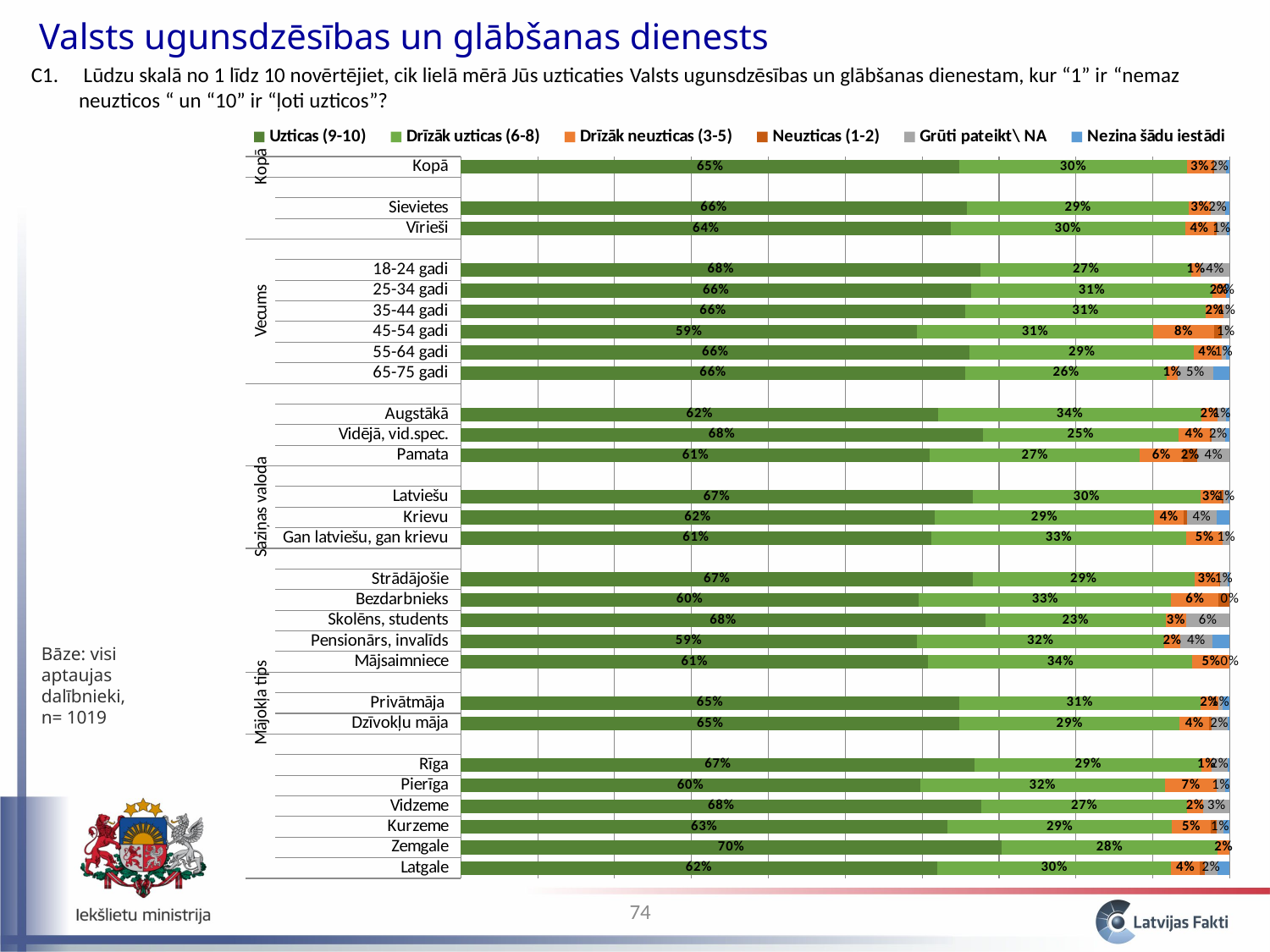
What is the difference between the Uzticas (9-10) values for Sievietes and Vīrieši? 2% Which region has the highest Uzticas (9-10) share among Rīga, Pierīga, Vidzeme, Kurzeme, Zemgale and Latgale? Zemgale How many series does the legend list? 6 What type of chart is shown on the slide? Stacked bar chart Which has a larger Uzticas (9-10) value, Skolēns, students or Bezdarbnieks? Skolēns, students What is the Drīzāk uzticas (6-8) value for Pierīga? 32% What percentage of all respondents (Kopā) answered Uzticas (9-10)? 65% What is the difference between the Drīzāk uzticas (6-8) values for Augstākā and Vidējā, vid.spec.? 9% Which age group has the highest Drīzāk neuzticas (3-5) value? 45-54 gadi What is the Drīzāk neuzticas (3-5) value for the 45-54 gadi group? 8% What is the Drīzāk uzticas (6-8) value for Augstākā? 34% What is the sample size (n) stated on the slide? 1019